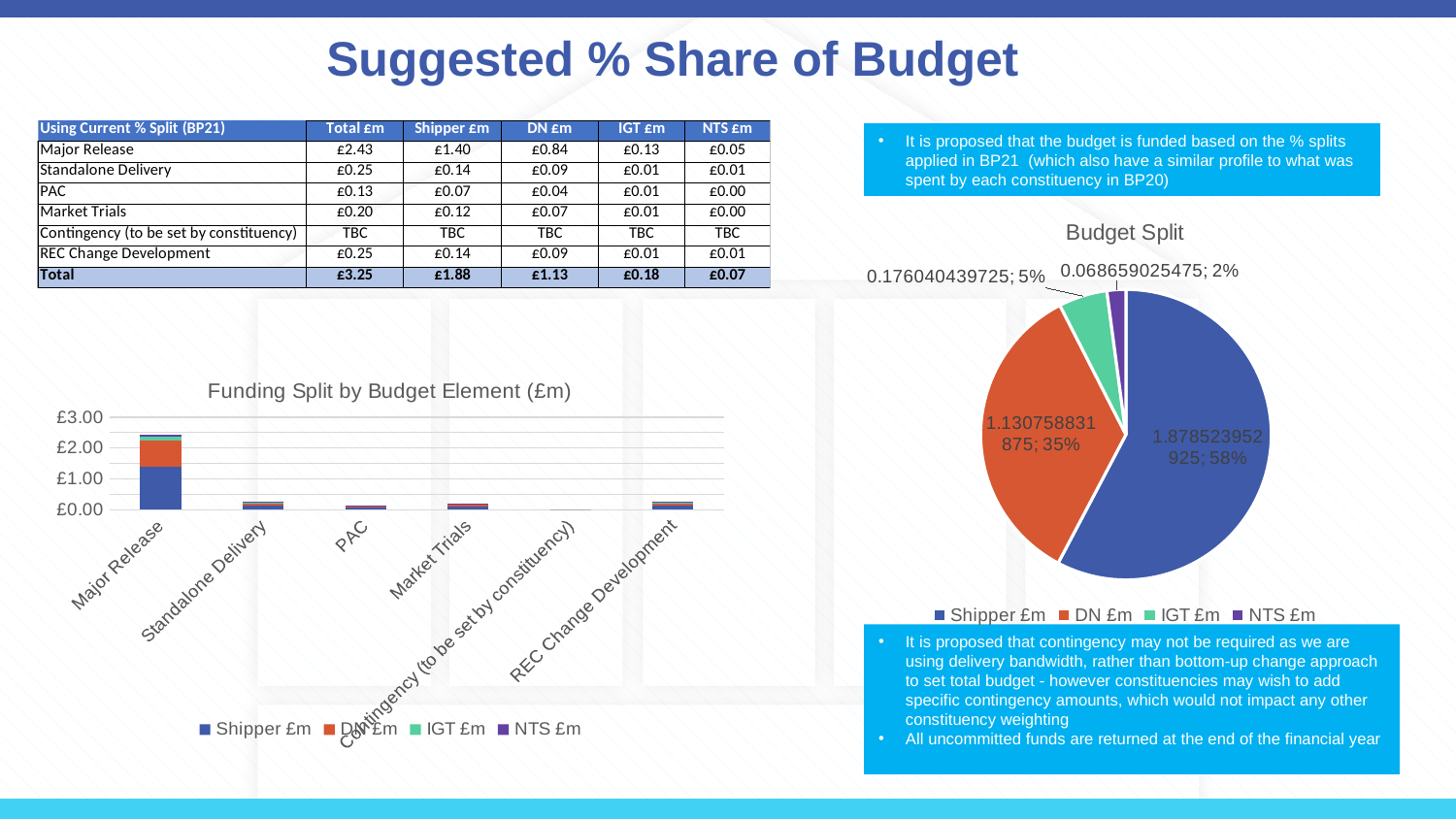
In the Funding Split by Budget Element (£m) chart, is the total bar for Major Release greater or less than £2.00? greater What kind of chart is the Funding Split by Budget Element (£m) chart? Stacked bar chart How many series does the legend of the Funding Split by Budget Element (£m) chart list? 4 In the Budget Split pie chart, what share of the budget does IGT £m represent? 5% In the Budget Split pie chart, what share of the budget does DN £m represent? 35% How many budget element categories are shown on the x axis of the Funding Split by Budget Element (£m) chart? 6 In the Budget Split pie chart, what share of the budget does NTS £m represent? 2% In the Budget Split pie chart, which constituency has the smallest slice? NTS £m In the Budget Split pie chart, which slice is larger, Shipper £m or DN £m? Shipper £m What kind of chart is the Budget Split chart? Pie chart In the Budget Split pie chart, which constituency has the largest slice? Shipper £m